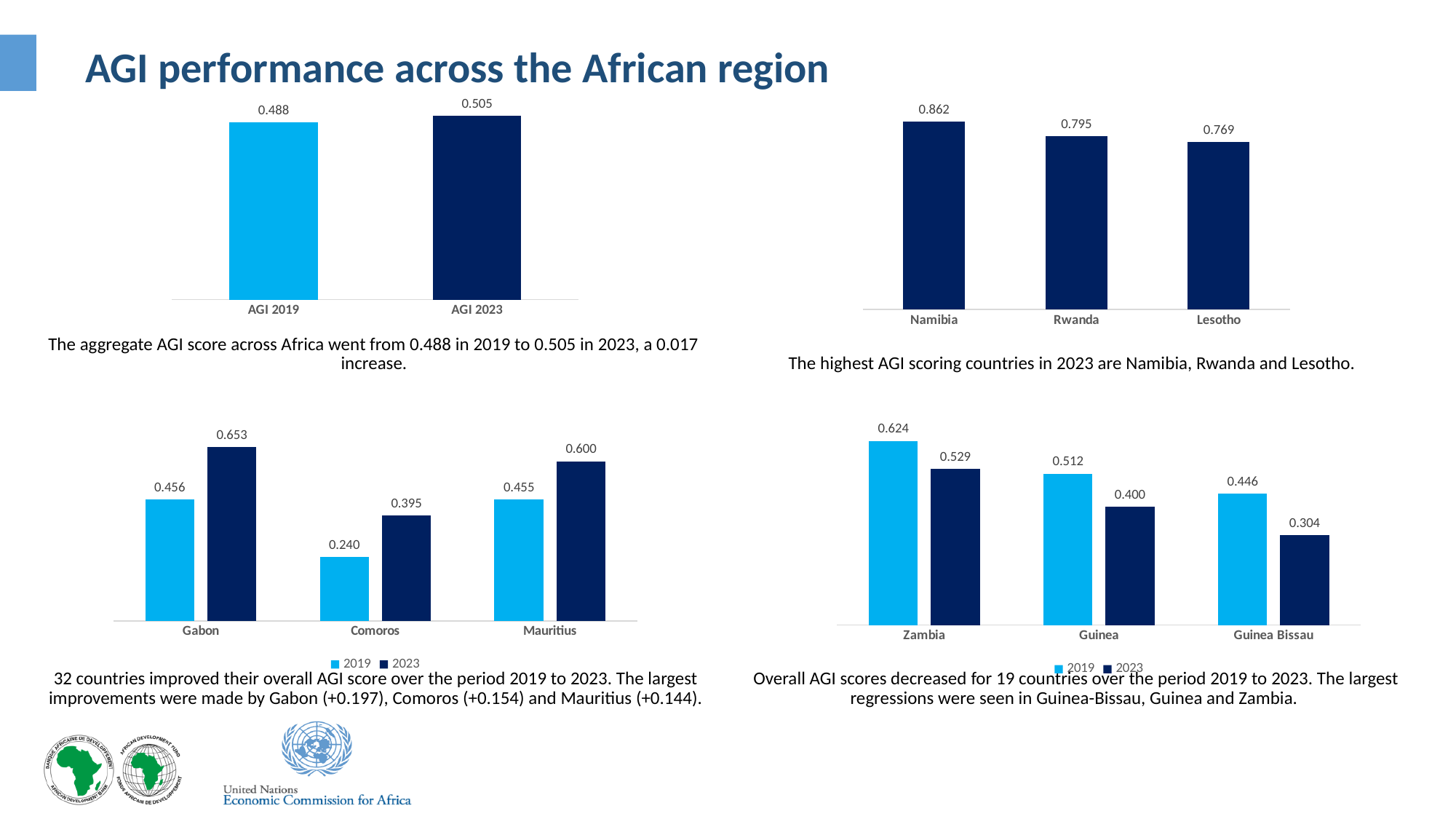
In the bottom-left chart, which country has the lowest 2019 value? Comoros In the bottom-right chart, which is larger: the 2023 value for Guinea or the 2023 value for Guinea Bissau? Guinea In the top-left chart, what is the difference between the AGI 2023 and AGI 2019 values? 0.017 In the bottom-right chart, what is the 2019 value for Zambia? 0.624 In the top-right chart, how many countries are shown? 3 What kind of chart is the bottom-right chart? Bar chart In the top-right chart, what is the value for Lesotho? 0.769 In the bottom-left chart, what is the difference between the 2023 and 2019 values for Gabon? 0.197 In the bottom-left chart, what is the 2023 value for Comoros? 0.395 In the top-left chart, what is the value for AGI 2023? 0.505 In the bottom-left chart, how many series does the legend list? 2 In the top-right chart, which country has the highest value? Namibia